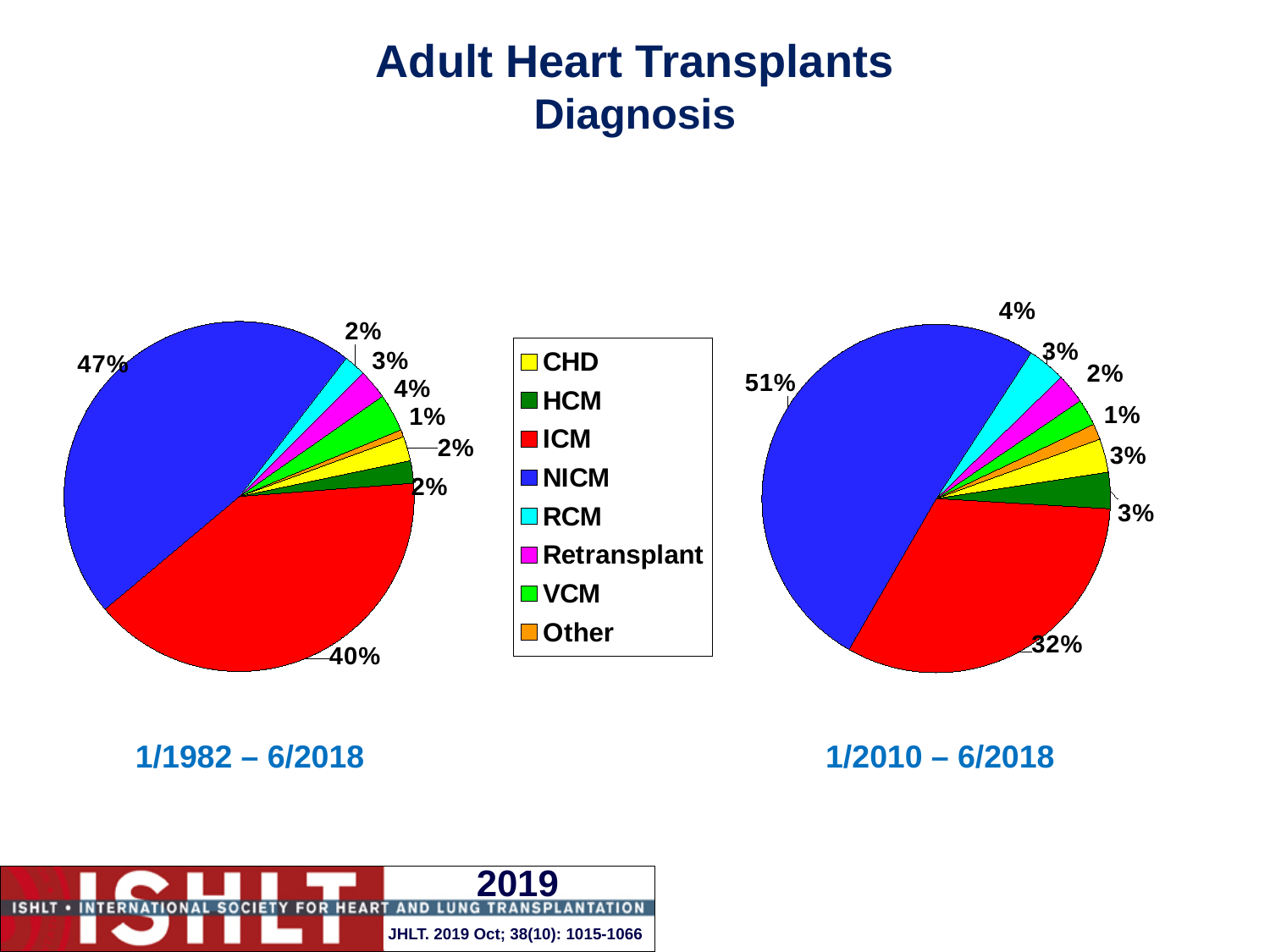
In the 1/2010 – 6/2018 pie chart, what share of adult heart transplants had a diagnosis of ICM? 32% In the 1/1982 – 6/2018 pie chart, which diagnosis has the largest share? NICM In the 1/1982 – 6/2018 pie chart, what share of adult heart transplants had a diagnosis of NICM? 47% What kind of chart is used on this slide to show the diagnosis breakdown? Pie chart In the 1/2010 – 6/2018 pie chart, what share is labelled for NICM? 51% How many diagnosis categories does the legend list? 8 Is the NICM share larger in the 1/1982 – 6/2018 pie chart or in the 1/2010 – 6/2018 pie chart? 1/2010 – 6/2018 In the 1/2010 – 6/2018 pie chart, which diagnosis has the smallest share? Other In the 1/1982 – 6/2018 pie chart, how many percentage points larger is the NICM share than the ICM share? 7 percentage points According to the legend, what colour represents ICM? Red In the 1/1982 – 6/2018 pie chart, what share is labelled for ICM? 40% In the 1/2010 – 6/2018 pie chart, how many slices does the pie have? 8